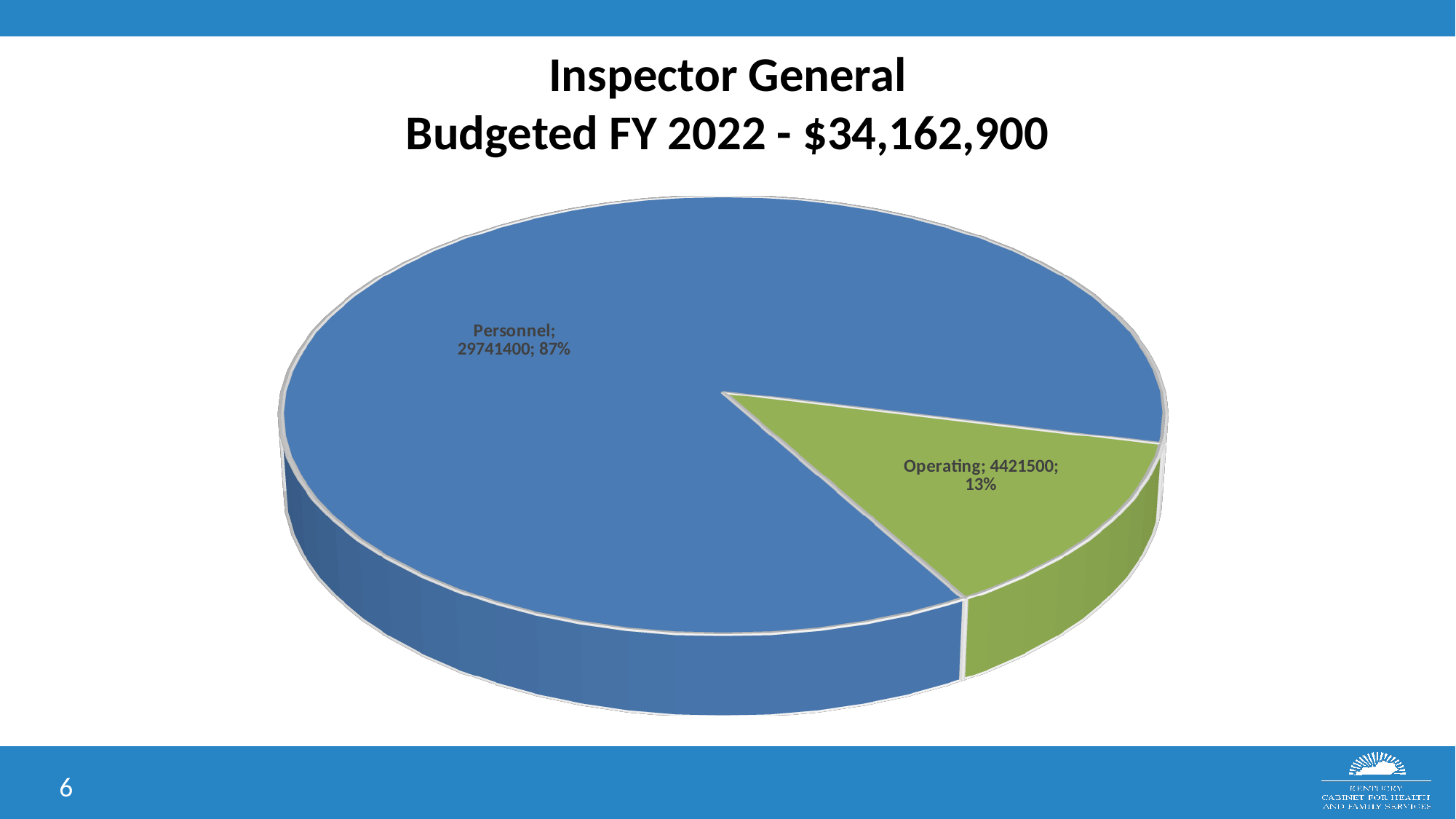
What is the value for Operating? 4421500 What colour is the Operating slice? Green Which category has the largest slice? Personnel What is the title of the slide? Inspector General Budgeted FY 2022 - $34,162,900 What kind of chart is shown on the slide? Pie chart What is the difference between the Personnel and Operating values? 25319900 What share of the pie does Personnel represent? 87% How many slices does the pie chart have? 2 Which category has the smallest slice? Operating What share of the pie does Operating represent? 13% Which is larger, Personnel or Operating? Personnel What is the value for Personnel? 29741400